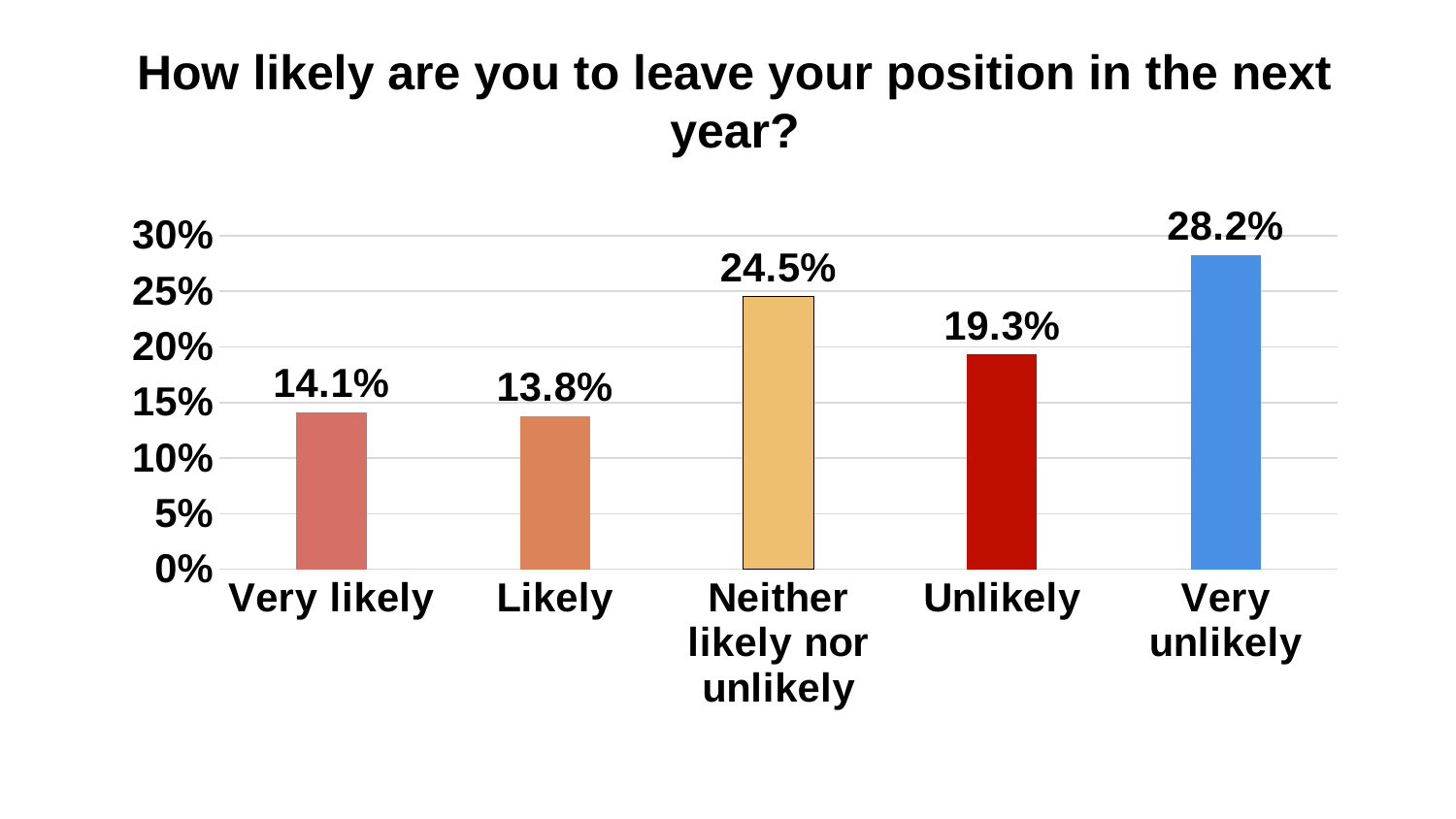
What percentage of respondents said they are very unlikely to leave their position in the next year? 28.2% Is the value for 'Very unlikely' greater or less than 25%? greater Which category has the lowest value? Likely How many categories are shown on the x axis? 5 What kind of chart is shown on the slide? Bar chart What percentage of respondents answered 'Unlikely'? 19.3% Which category has the highest value? Very unlikely What is the value for the 'Neither likely nor unlikely' category? 24.5% What is the difference between the 'Very unlikely' and 'Very likely' values? 14.1% What is the difference between the 'Neither likely nor unlikely' and 'Unlikely' values? 5.2% Which is larger, the value for 'Unlikely' or the value for 'Very likely'? Unlikely What is the title of the chart? How likely are you to leave your position in the next year?